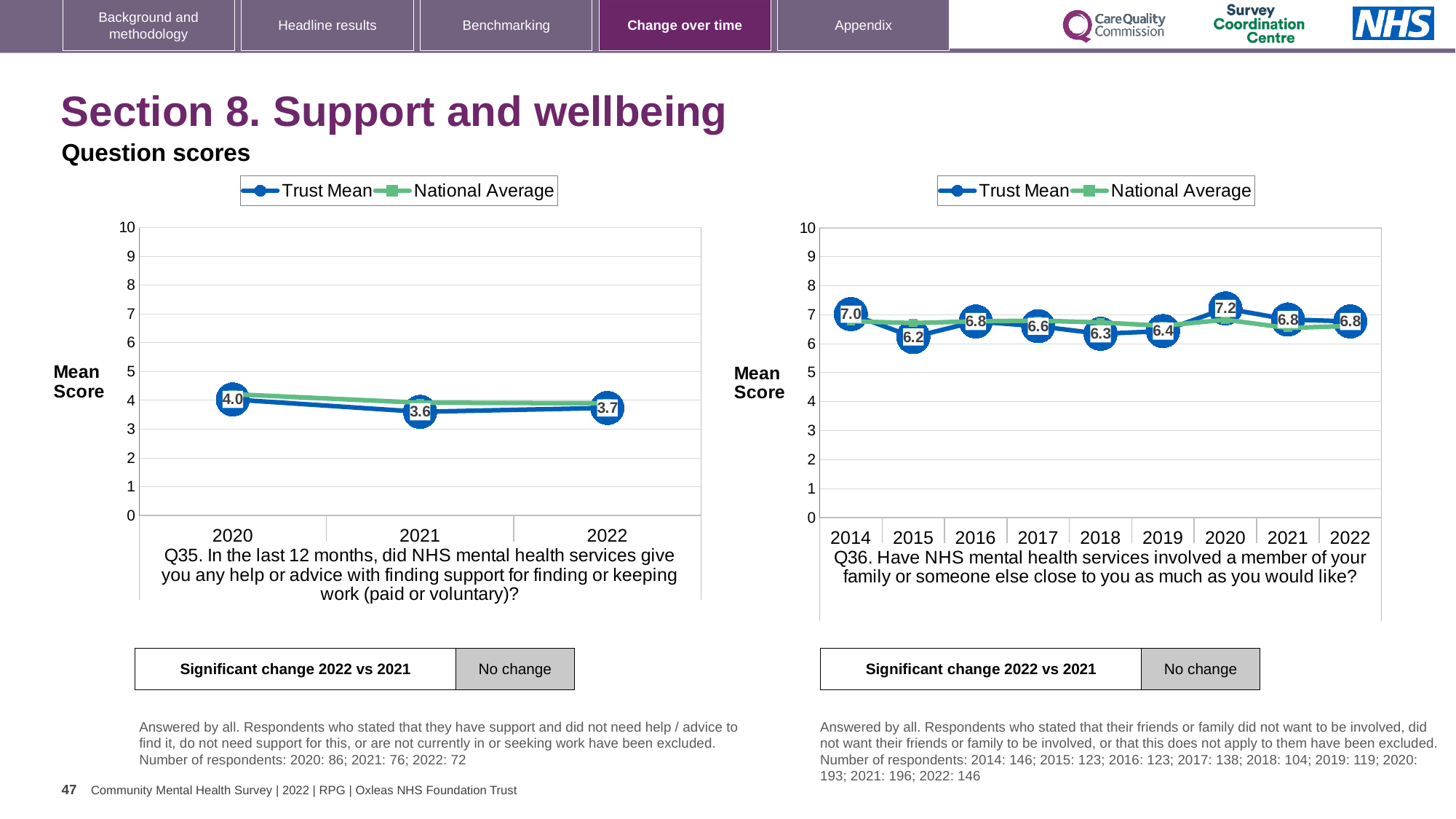
On the Q36 chart (right), what is the Trust Mean score for 2015? 6.2 What type of chart is used for Q35 (left)? Line chart On the Q36 chart (right), is the Trust Mean score for 2014 larger or smaller than the score for 2018? larger On the Q35 chart (left), which year has the lowest Trust Mean score? 2021 On the Q35 chart (left), how many years are plotted on the x axis? 3 On the Q36 chart (right), what is the Trust Mean score for 2020? 7.2 On the Q36 chart (right), which year has the highest Trust Mean score? 2020 On the Q35 chart (left), what is the Trust Mean score for 2020? 4.0 On the Q36 chart (right), how many series does the legend list? 2 On the Q35 chart (left), what is the difference between the Trust Mean scores for 2020 and 2021? 0.4 On the Q35 chart (left), what is the Trust Mean score for 2022? 3.7 On the Q36 chart (right), which year has the lowest Trust Mean score? 2015